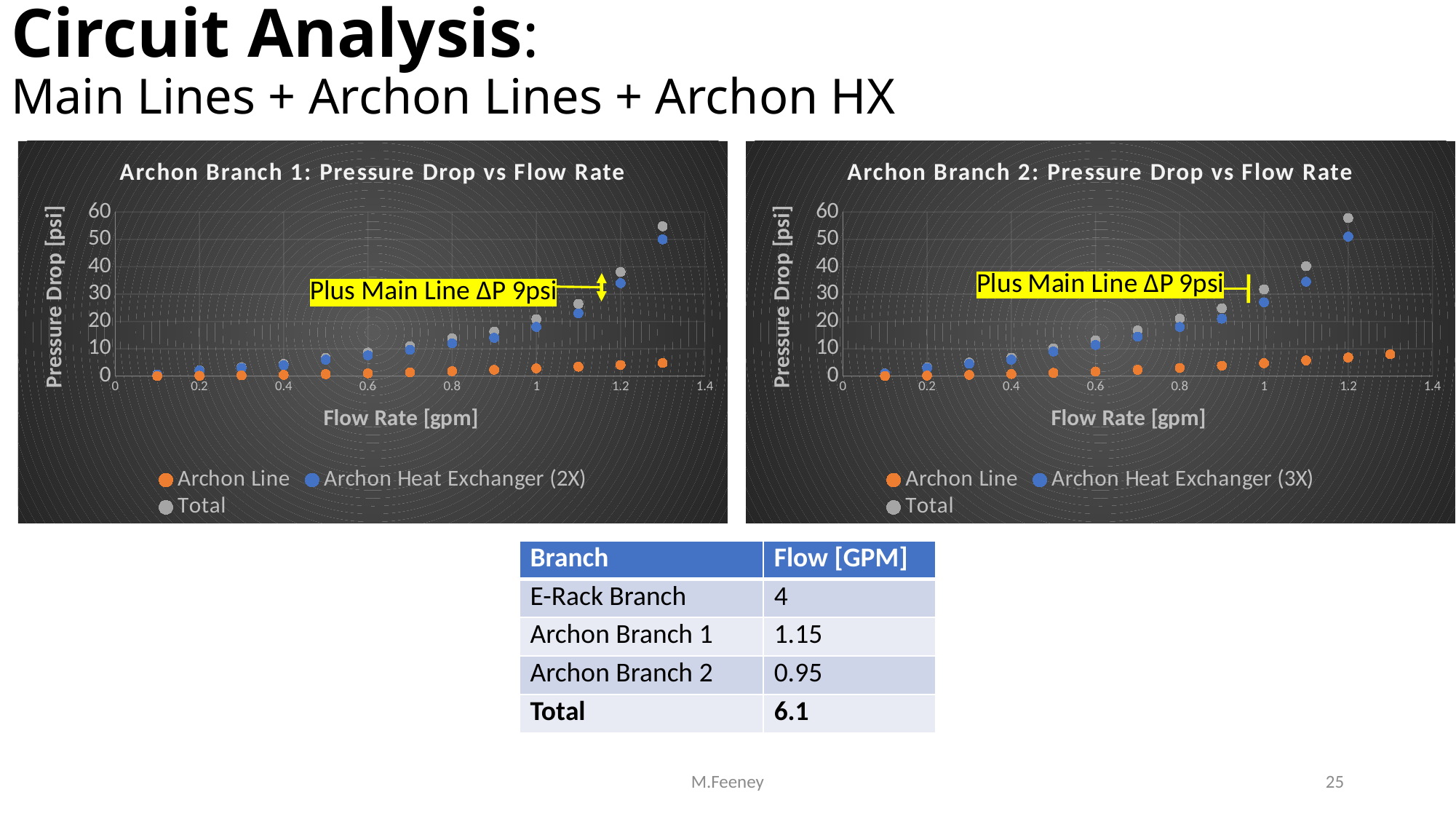
How many series does the legend of the Archon Branch 1: Pressure Drop vs Flow Rate chart list? 3 In the Archon Branch 1: Pressure Drop vs Flow Rate chart, which series has the highest pressure drop at a flow rate of 1.2 gpm? Total In the Archon Branch 2: Pressure Drop vs Flow Rate chart, does the Total pressure drop rise or fall as flow rate increases? Rises In the Archon Branch 2: Pressure Drop vs Flow Rate chart, is the Archon Line value at a flow rate of 1.3 gpm greater or less than 10? less What is the label of the x axis on the Archon Branch 2: Pressure Drop vs Flow Rate chart? Flow Rate [gpm] How many series does the legend of the Archon Branch 2: Pressure Drop vs Flow Rate chart list? 3 In the Archon Branch 2: Pressure Drop vs Flow Rate chart, is the Total value at a flow rate of 1.2 gpm greater or less than 50? greater In the Archon Branch 1: Pressure Drop vs Flow Rate chart, which is larger at a flow rate of 1.0 gpm: Total or Archon Line? Total What kind of chart is the Archon Branch 1: Pressure Drop vs Flow Rate chart? Scatter chart In the Archon Branch 1: Pressure Drop vs Flow Rate chart, is the Total value at a flow rate of 1.3 gpm greater or less than 50? greater In the Archon Branch 2: Pressure Drop vs Flow Rate chart, which series has the lowest pressure drop at a flow rate of 1.2 gpm? Archon Line